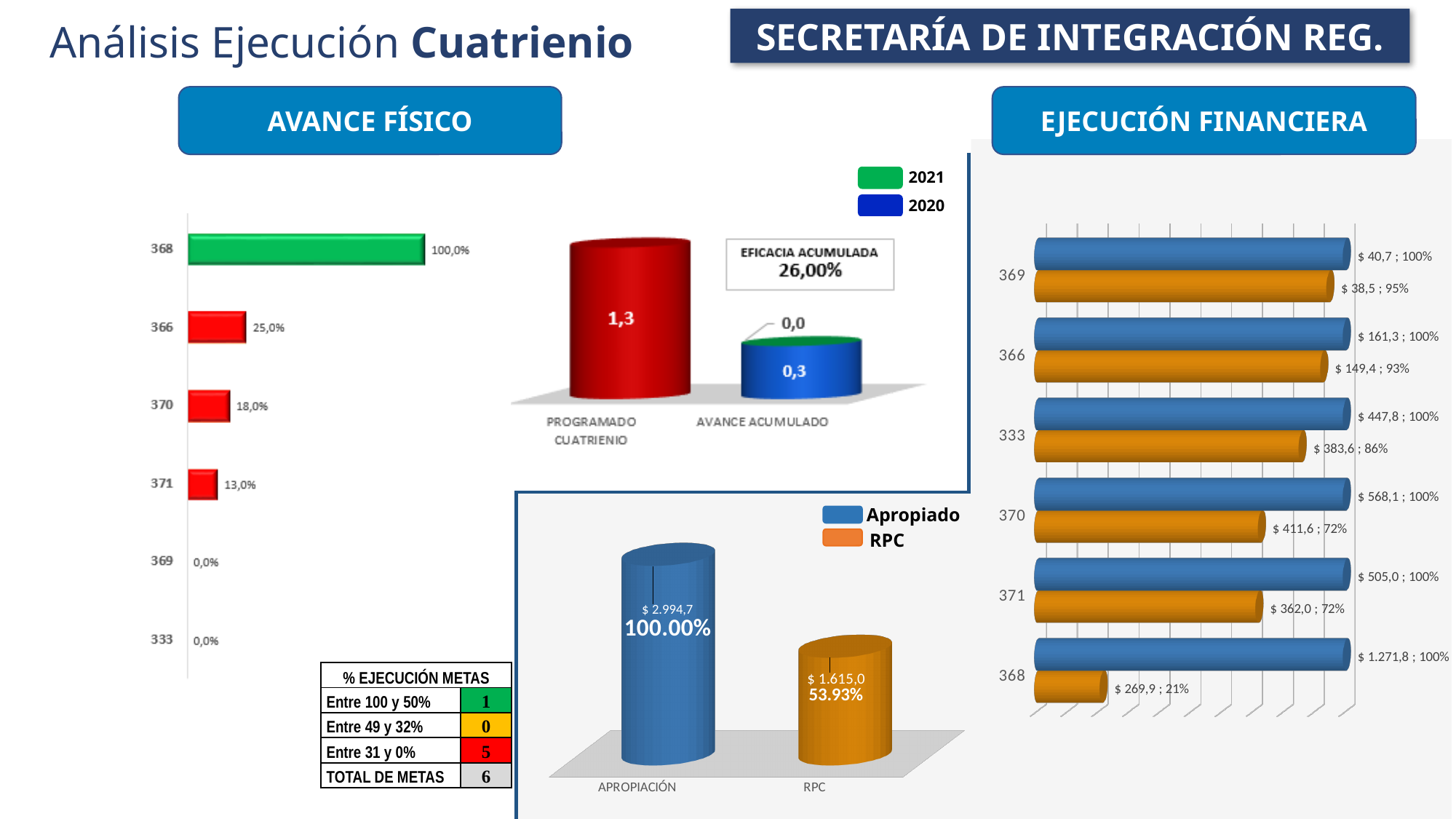
In the Ejecución Financiera chart on the right, what is the Apropiado value for category 370? $ 568,1 ; 100% In the Avance Físico bar chart on the left, which category has the highest value? 368 In the Ejecución Financiera chart on the right, how many series does the legend list? 2 In the Programado Cuatrienio vs Avance Acumulado chart, what is the Eficacia Acumulada shown? 26,00% In the Avance Físico bar chart on the left, how many categories are shown? 6 In the Ejecución Financiera chart on the right, which category has the highest Apropiado value? 368 In the Avance Físico bar chart on the left, what is the difference between the values for 370 and 371? 5,0% In the Apropiación vs RPC chart at the bottom centre, what is the value for RPC? $ 1.615,0 In the Apropiación vs RPC chart at the bottom centre, what percentage is shown for RPC? 53.93% In the Programado Cuatrienio vs Avance Acumulado chart, what is the value for Programado Cuatrienio? 1,3 In the Avance Físico bar chart on the left, what is the value for category 366? 25,0% In the Ejecución Financiera chart on the right, what is the RPC value for category 368? $ 269,9 ; 21%